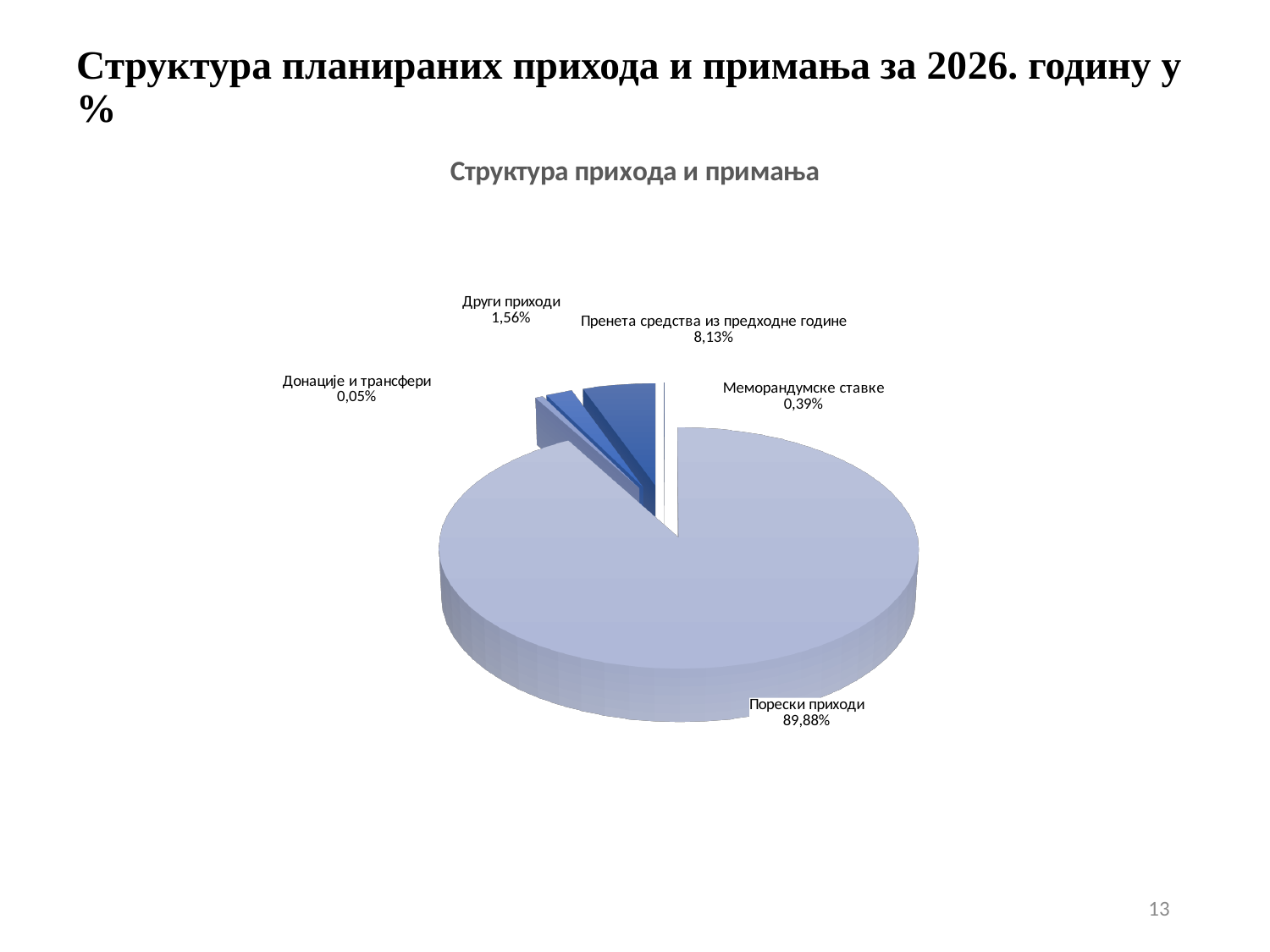
What share of the pie is Меморандумске ставке? 0,39% What share of the pie is Донације и трансфери? 0,05% What share of the pie is Други приходи? 1,56% What share of the pie is Пренета средства из предходне године? 8,13% Which category has the smallest share of the pie? Донације и трансфери What kind of chart is shown on the slide? Pie chart Which category has the largest share of the pie? Порески приходи How many categories (slices) does the pie chart have? 5 What is the title of the chart? Структура прихода и примања What share of the pie is Порески приходи? 89,88% What is the difference between the share for Порески приходи and the share for Пренета средства из предходне године? 81,75% Which is larger, the share for Пренета средства из предходне године or the share for Други приходи? Пренета средства из предходне године